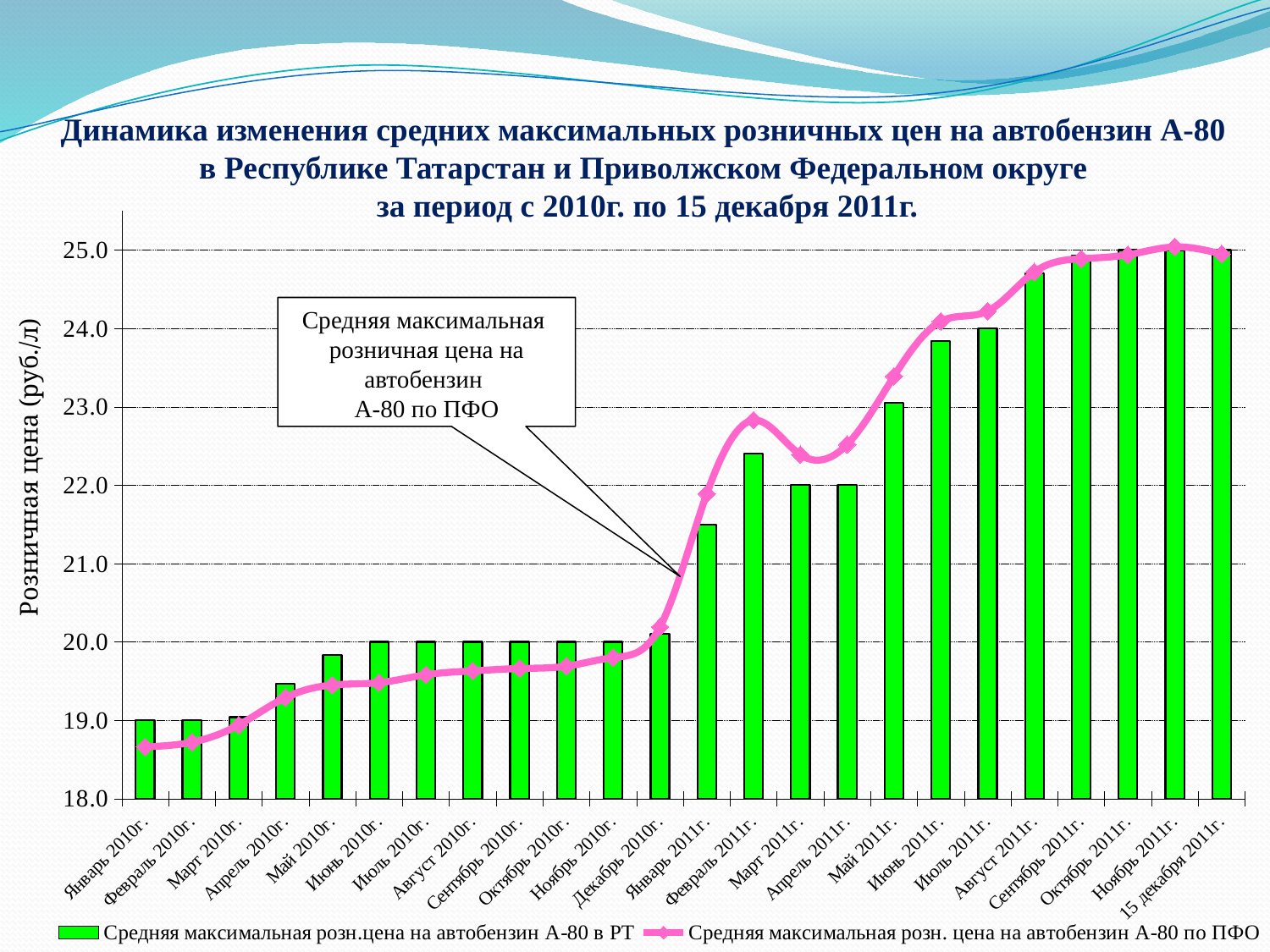
What kind of chart is shown on the slide? A combined bar and line chart In Февраль 2011г., which is higher: the bar (price in RT) or the line (price in ПФО)? The line (price in ПФО) Which bar is taller: Февраль 2011г. or Март 2011г.? Февраль 2011г. How many months (categories) are plotted along the x axis? 24 What is the label of the vertical axis? Розничная цена (руб./л) Is the bar value for Август 2011г. (average maximum retail price in RT) greater or less than 24.0? greater Is the line value for Январь 2010г. (average maximum retail price in ПФО) greater or less than 19.0? less How many series does the legend list? 2 Is the line value for Декабрь 2010г. (average maximum retail price in ПФО) greater or less than 21.0? less Do the retail prices for A-80 petrol in the Republic of Tatarstan generally rise or fall from January 2010 to 15 December 2011? Rise